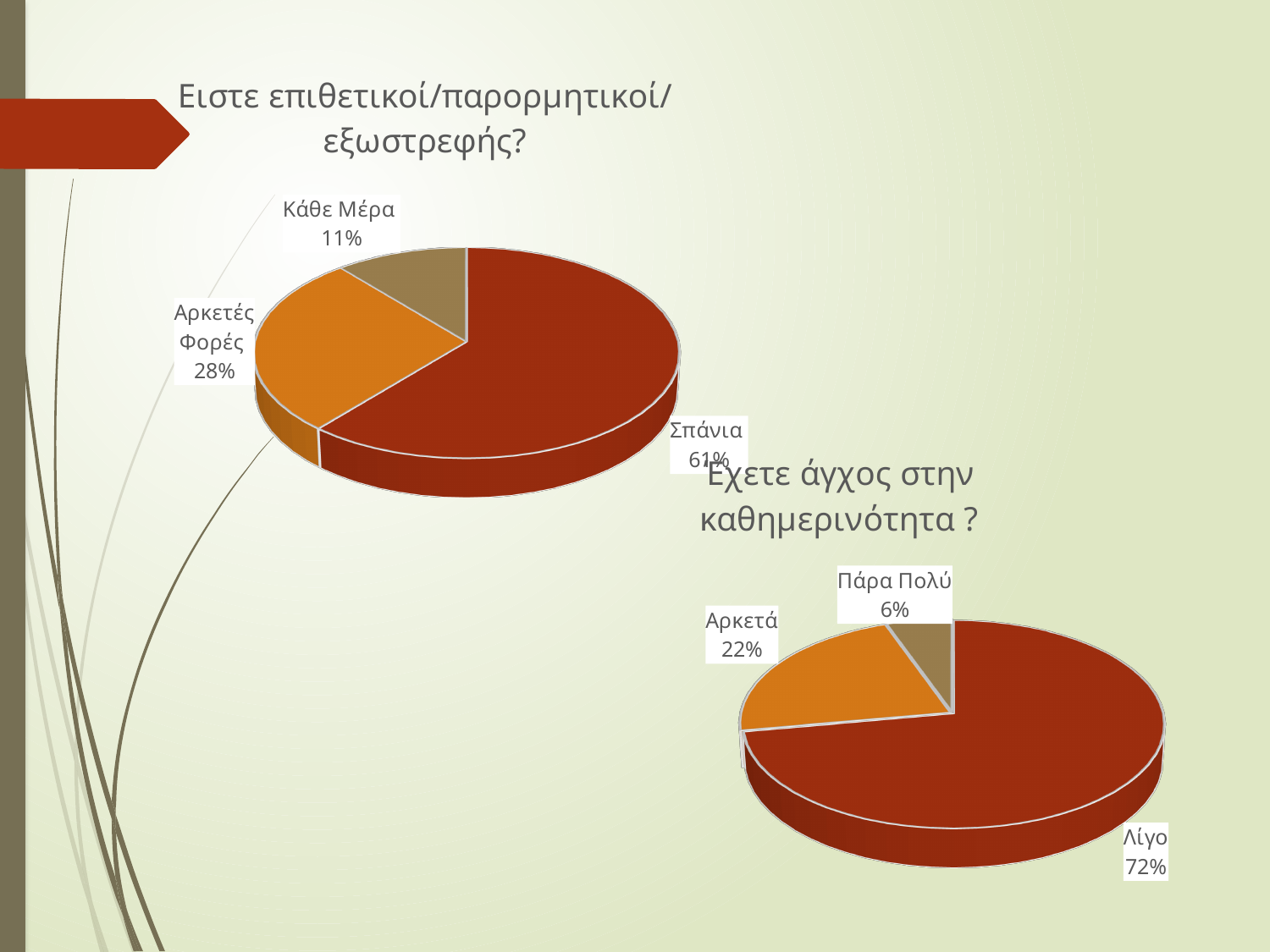
In the chart titled "Έχετε άγχος στην καθημερινότητα ?", what percentage is shown for "Αρκετά"? 22% In the chart titled "Έχετε άγχος στην καθημερινότητα ?", which is larger, "Αρκετά" or "Πάρα Πολύ"? Αρκετά In the chart titled "Ειστε επιθετικοί/παρορμητικοί/εξωστρεφής?", which category has the smallest slice? Κάθε Μέρα In the chart titled "Έχετε άγχος στην καθημερινότητα ?", which category has the smallest slice? Πάρα Πολύ What type of chart is used for "Έχετε άγχος στην καθημερινότητα ?"? Pie chart In the chart titled "Έχετε άγχος στην καθημερινότητα ?", what percentage is shown for "Λίγο"? 72% In the chart titled "Ειστε επιθετικοί/παρορμητικοί/εξωστρεφής?", what percentage is shown for "Αρκετές Φορές"? 28% In the chart titled "Ειστε επιθετικοί/παρορμητικοί/εξωστρεφής?", which category has the largest slice? Σπάνια In the chart titled "Ειστε επιθετικοί/παρορμητικοί/εξωστρεφής?", what is the difference between "Αρκετές Φορές" and "Κάθε Μέρα"? 17% In the chart titled "Έχετε άγχος στην καθημερινότητα ?", what percentage is shown for "Πάρα Πολύ"? 6% In the chart titled "Ειστε επιθετικοί/παρορμητικοί/εξωστρεφής?", how many slices does the pie have? 3 In the chart titled "Ειστε επιθετικοί/παρορμητικοί/εξωστρεφής?", what percentage is shown for "Κάθε Μέρα"? 11%